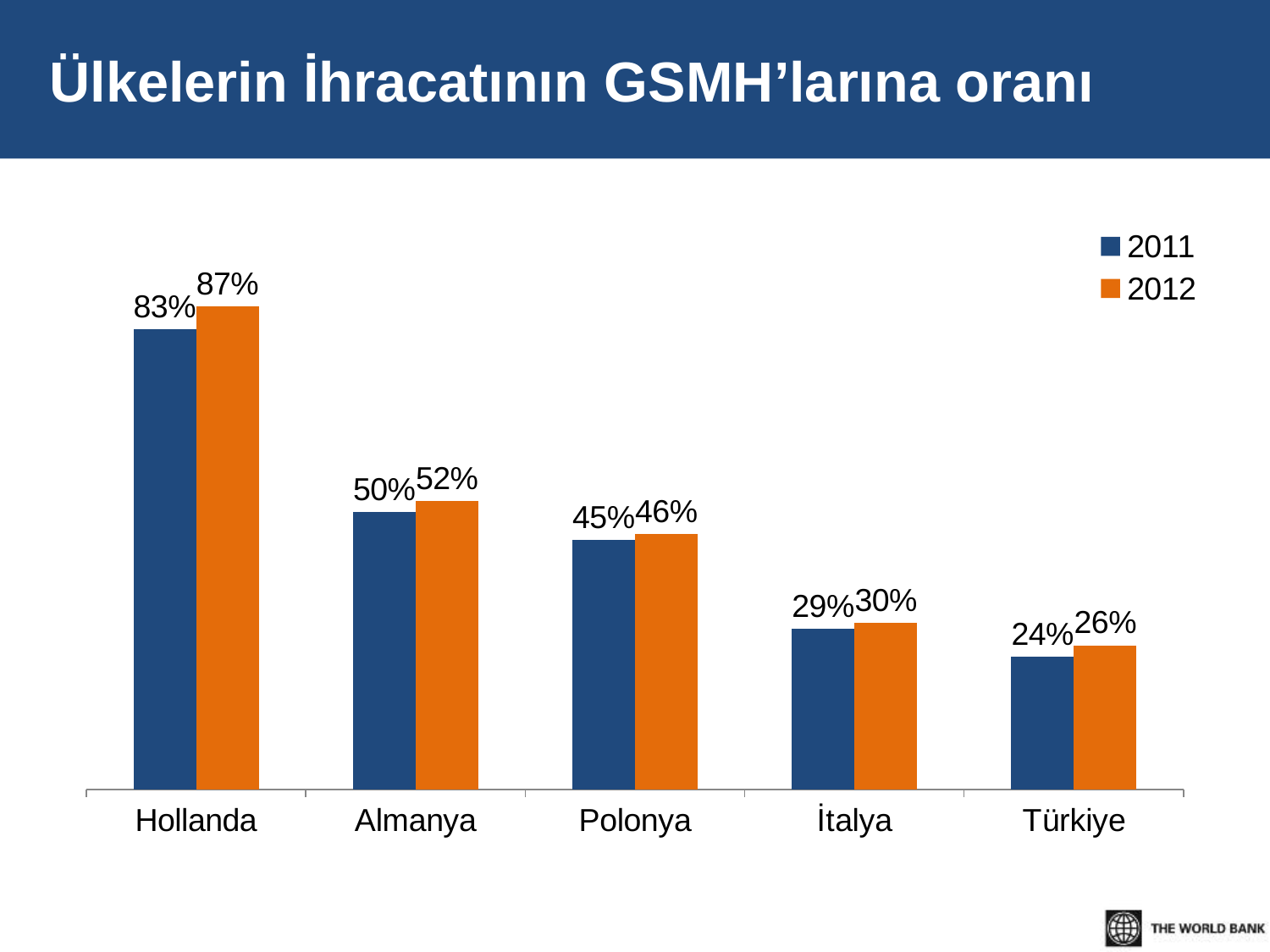
How many countries are shown on the x axis? 5 Which country has the lowest 2011 value? Türkiye Which colour represents 2012 in the legend? Orange Which country has the highest 2012 value? Hollanda What is the 2012 value for Hollanda? 87% What is the 2011 value for Polonya? 45% What is the difference between the 2012 and 2011 values for Hollanda? 4% Which is larger, the 2012 value for Almanya or the 2012 value for Polonya? Almanya What kind of chart is shown on the slide? Bar chart What is the 2011 value for Türkiye? 24% How many series does the legend list? 2 What is the difference between the 2011 values for Almanya and İtalya? 21%